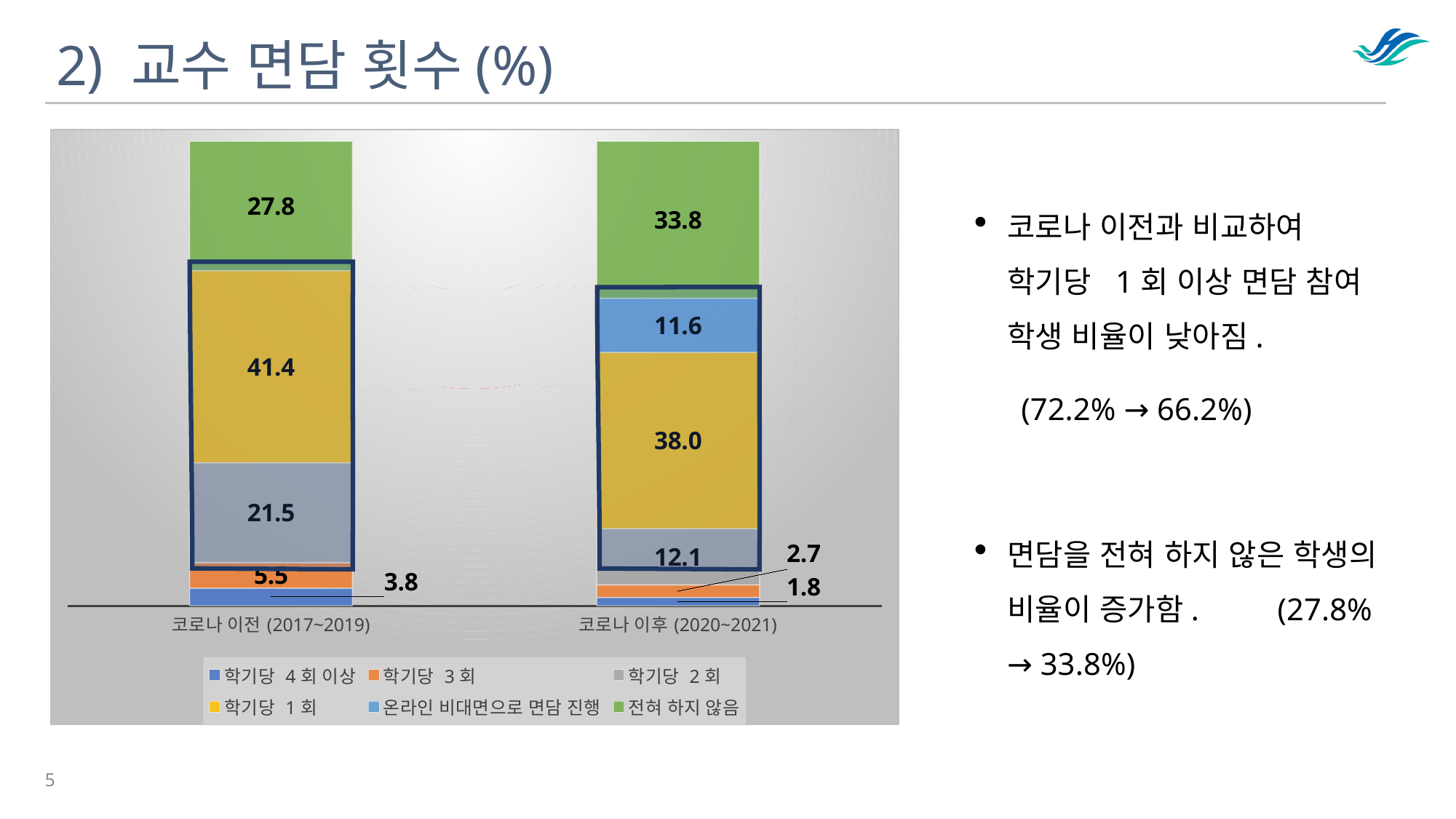
What is the title of the slide containing the chart? 2) 교수 면담 횟수 (%) What is the value for 전혀 하지 않음 in the 코로나 이후 (2020~2021) bar? 33.8 What kind of chart is shown on the slide? Stacked bar chart What is the value for 학기당 4회 이상 in the 코로나 이전 (2017~2019) bar? 3.8 How many categories are shown on the x axis of the chart? 2 How many series does the chart legend list? 6 What is the value for 온라인 비대면으로 면담 진행 in the 코로나 이후 (2020~2021) bar? 11.6 Which bar has the larger value for 학기당 2회, 코로나 이전 (2017~2019) or 코로나 이후 (2020~2021)? 코로나 이전 (2017~2019) What is the difference between the 학기당 1회 values for 코로나 이전 (2017~2019) and 코로나 이후 (2020~2021)? 3.4 What is the value for 학기당 1회 in the 코로나 이전 (2017~2019) bar? 41.4 What is the value for 학기당 2회 in the 코로나 이후 (2020~2021) bar? 12.1 What is the value for 전혀 하지 않음 in the 코로나 이전 (2017~2019) bar? 27.8